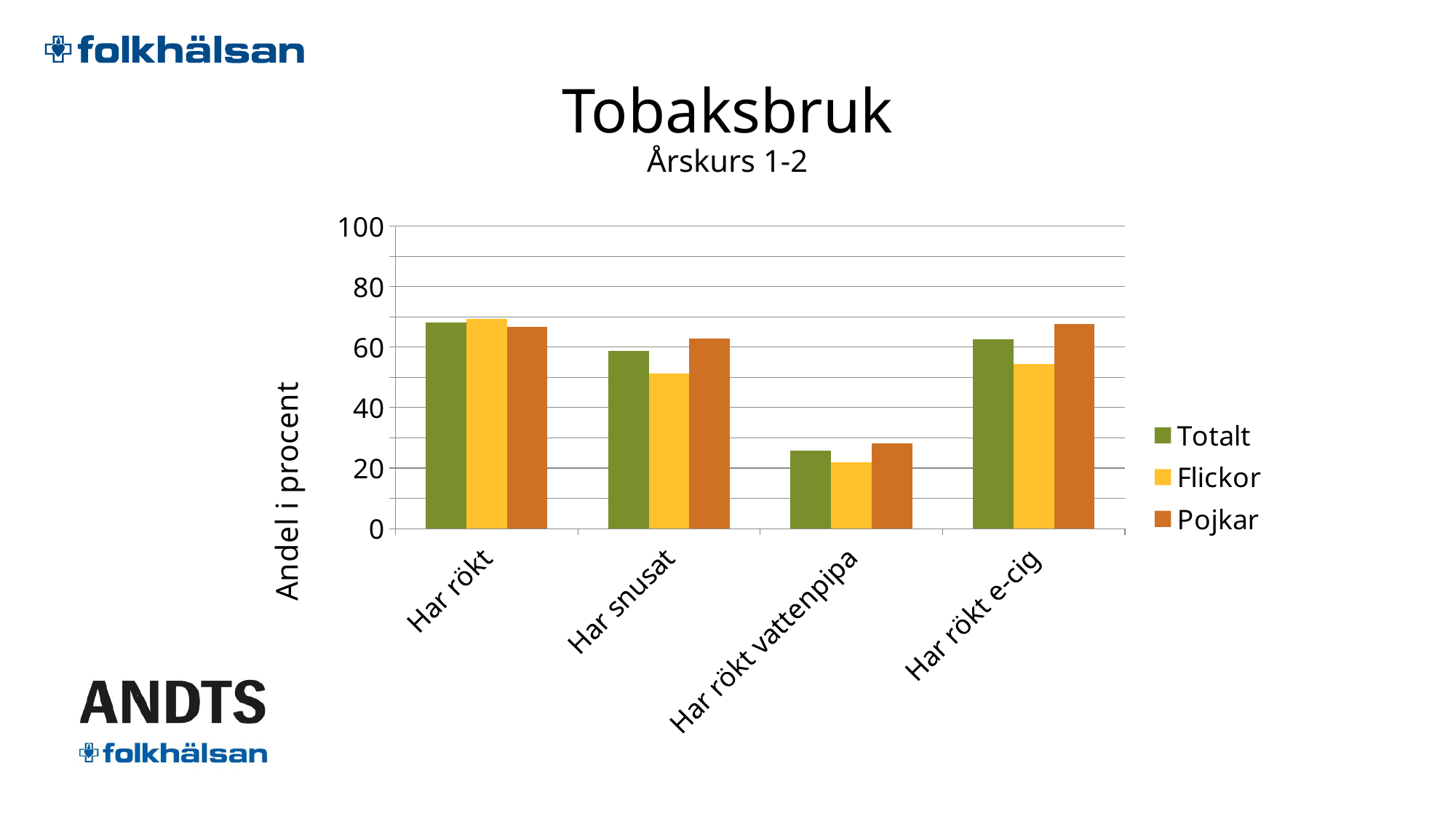
Is the value for Flickor in Har rökt vattenpipa greater or less than 40? less Is the value for Flickor in Har snusat greater or less than 60? less For Har snusat, which is larger: Flickor or Pojkar? Pojkar Which category has the highest value for Totalt? Har rökt How many series does the legend list? 3 For Har rökt e-cig, which is larger: Flickor or Pojkar? Pojkar What is the title of the chart? Tobaksbruk Which category has the lowest value for Totalt? Har rökt vattenpipa What is the label of the vertical axis? Andel i procent What kind of chart is shown on the slide? bar chart How many categories are shown on the x axis of the chart? 4 Is the value for Totalt in Har rökt greater or less than 60? greater